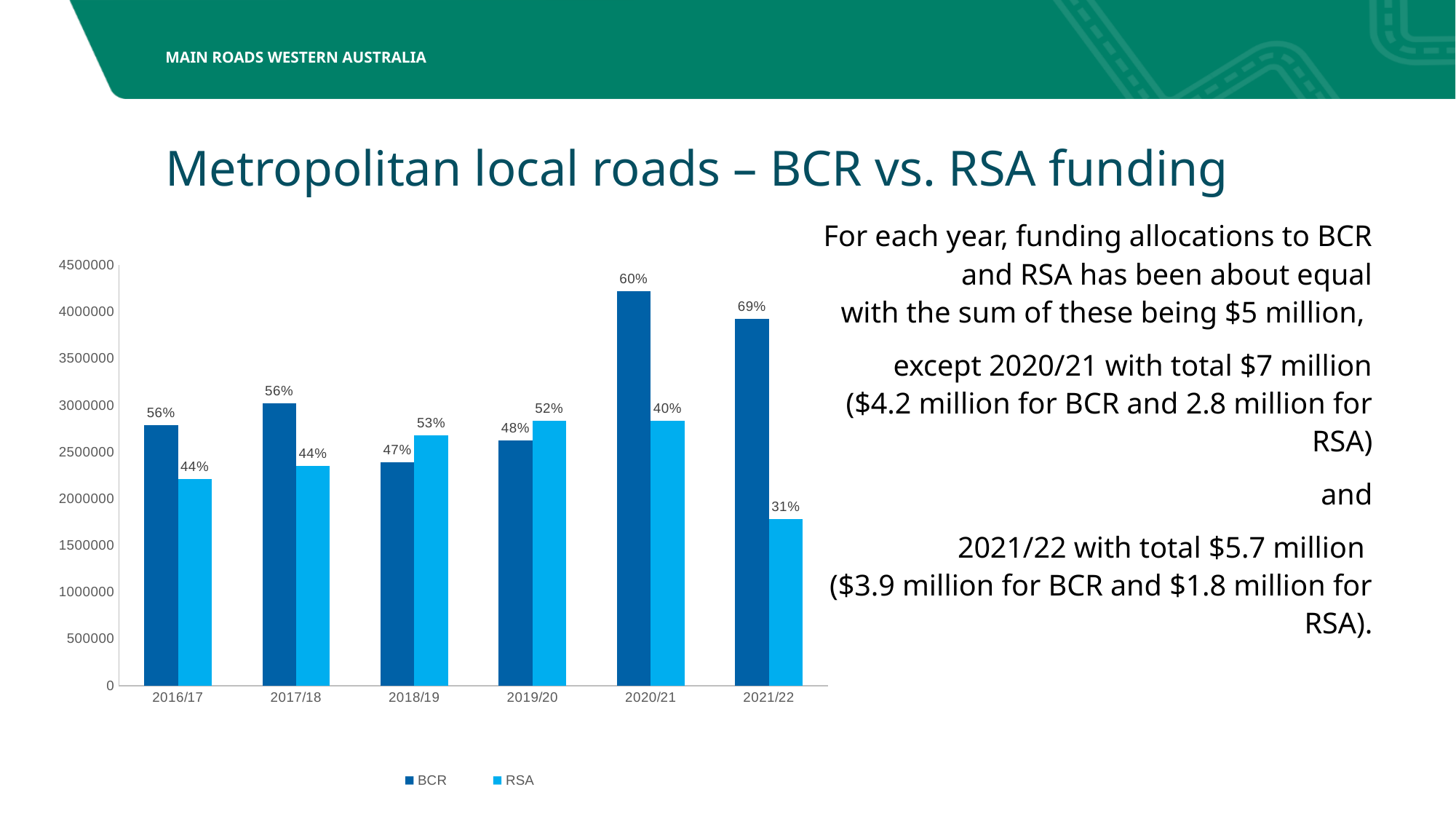
By how many percentage points does the BCR label exceed the RSA label in 2021/22? 38 percentage points What percentage label is shown on the RSA bar for 2021/22? 31% What percentage label is shown on the RSA bar for 2018/19? 53% What kind of chart is shown on the slide? bar chart In which year is the BCR bar the tallest? 2020/21 How many series does the legend list? 2 How many years are shown on the x axis? 6 In which year is the RSA bar the lowest? 2021/22 Is the value for RSA in 2016/17 greater or less than 2500000? less Is the value for BCR in 2021/22 greater or less than 3500000? greater What percentage label is shown on the BCR bar for 2020/21? 60% In 2018/19, which bar is taller, BCR or RSA? RSA